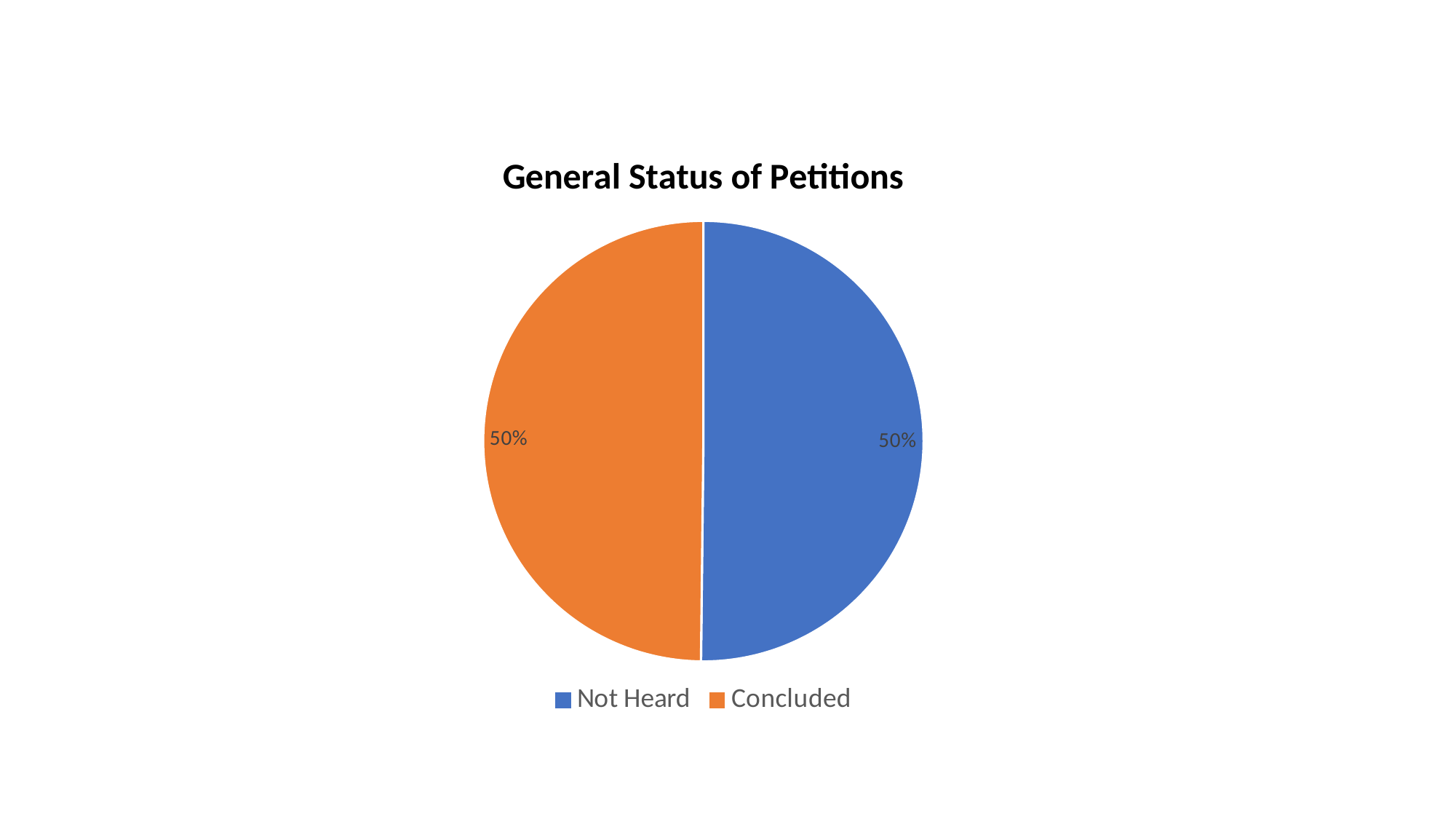
What share of the pie does Concluded represent? 50% How many slices does the pie chart have? 2 What is the combined share of Not Heard and Concluded? 100% Which colour represents Concluded in the pie chart? orange What is the title of the chart? General Status of Petitions What is the difference between the Not Heard share and the Concluded share? 0% What kind of chart is shown on the slide? pie chart How many entries does the legend list? 2 What share of the pie does Not Heard represent? 50%